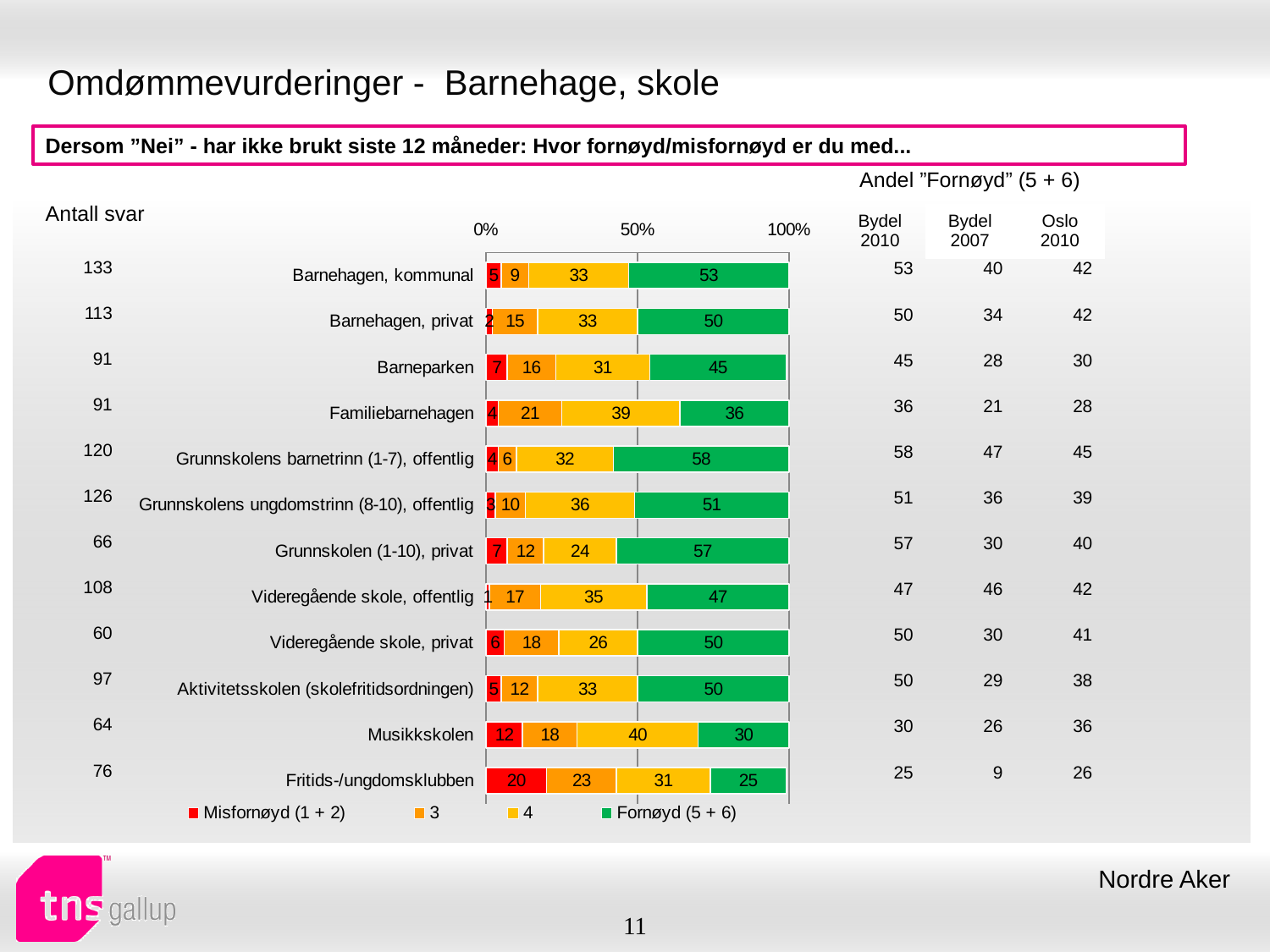
What is the Misfornøyd (1 + 2) value for Fritids-/ungdomsklubben? 20 Which has a larger Fornøyd (5 + 6) value, Barneparken or Familiebarnehagen? Barneparken Which category has the lowest Fornøyd (5 + 6) value? Fritids-/ungdomsklubben Which category has the highest Misfornøyd (1 + 2) value? Fritids-/ungdomsklubben How many series does the legend list? 4 Which category has the highest Fornøyd (5 + 6) value? Grunnskolens barnetrinn (1-7), offentlig What type of chart is shown on the slide? Stacked bar chart What is the value of series 4 for Musikkskolen? 40 What is the Fornøyd (5 + 6) value for Barnehagen, kommunal? 53 How many categories are shown in the chart? 12 What is the difference between the Fornøyd (5 + 6) values for Barnehagen, kommunal and Barnehagen, privat? 3 Is the Fornøyd (5 + 6) value for Barneparken greater or less than 50%? less